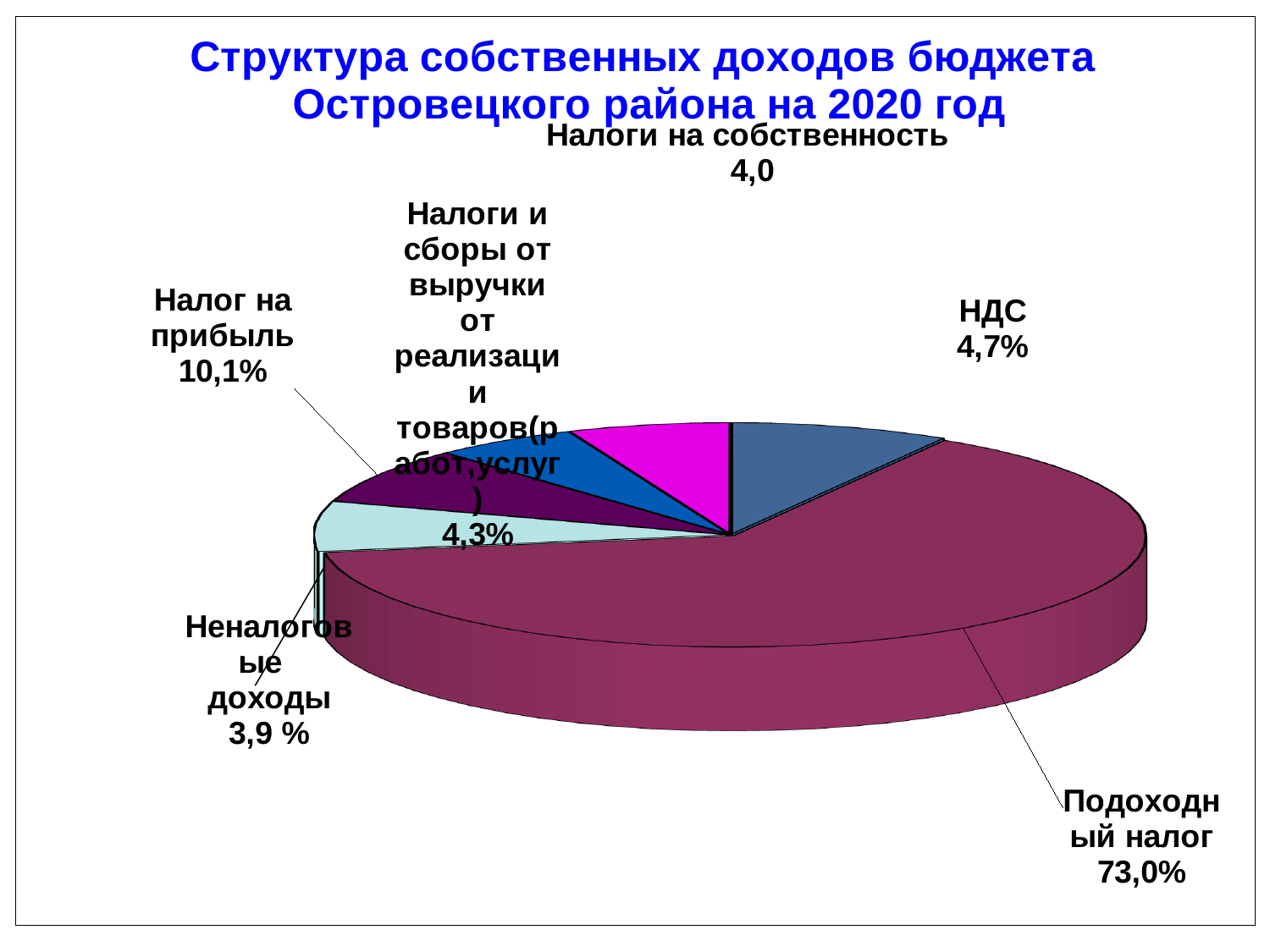
What is the value shown for Неналоговые доходы? 3,9 % What is the value shown for НДС? 4,7% Which is larger, the share of НДС or the share of Налоги на собственность? НДС Which category has the smallest slice of the pie? Неналоговые доходы What type of chart is shown on the slide? Pie chart What is the value shown for Налоги на собственность? 4,0 What share of the pie does Подоходный налог have? 73,0% Which category has the largest slice of the pie? Подоходный налог What is the value shown for Налог на прибыль? 10,1% How many slices does the pie chart have? 6 What is the value shown for Налоги и сборы от выручки от реализации товаров(работ,услуг)? 4,3% What is the difference between the shares of Подоходный налог and Налог на прибыль? 62,9%